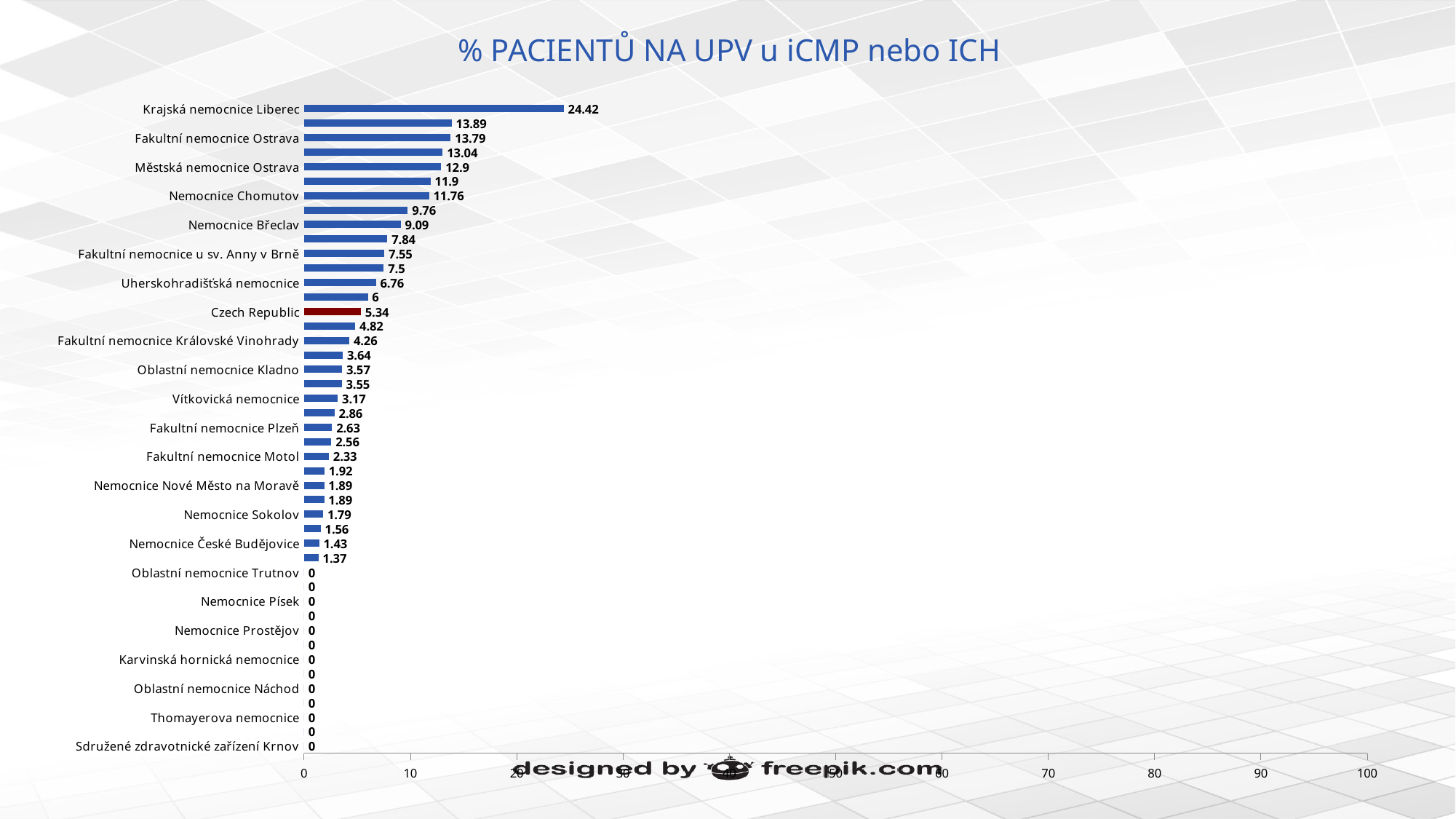
What is the value for Oblastní nemocnice Trutnov? 0 Which hospital has the highest value? Krajská nemocnice Liberec What kind of chart is shown on the slide? bar chart What is the value for Fakultní nemocnice Motol? 2.33 What is the difference between the values for Fakultní nemocnice Ostrava and Městská nemocnice Ostrava? 0.89 What is the value for Czech Republic? 5.34 What is the value for Nemocnice Chomutov? 11.76 Is the value for Krajská nemocnice Liberec greater or less than 20? greater What colour is the bar for Czech Republic? dark red What is the value for Krajská nemocnice Liberec? 24.42 Which is larger, the value for Nemocnice Břeclav or the value for Fakultní nemocnice u sv. Anny v Brně? Nemocnice Břeclav What is the difference between the values for Krajská nemocnice Liberec and Czech Republic? 19.08